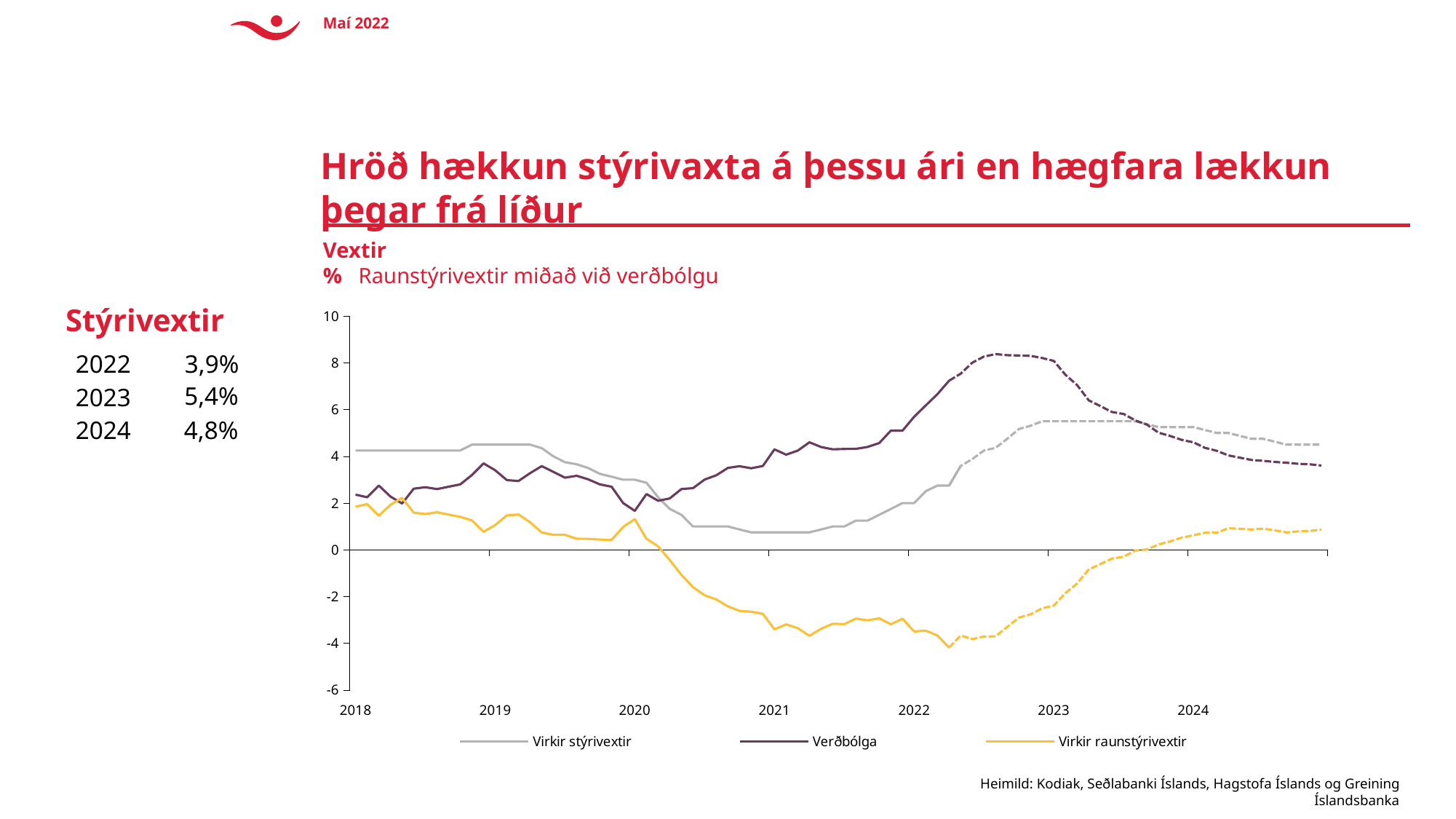
Is the value of Verðbólga at the 2022 tick greater or less than 4? greater Does Verðbólga rise or fall between the 2021 and 2022 ticks? rise What is the title of the chart? Vextir Is the value of Virkir stýrivextir at the 2019 tick greater or less than 4? greater At the 2022 tick, which is higher: Verðbólga or Virkir stýrivextir? Verðbólga Which series reaches the lowest value anywhere on the chart? Virkir raunstýrivextir How many series does the legend list? 3 What kind of chart is shown on the slide? line chart Is the value of Virkir raunstýrivextir at the 2021 tick greater or less than -2? less What are the three series named in the legend? Virkir stýrivextir, Verðbólga, Virkir raunstýrivextir Which series reaches the highest value anywhere on the chart? Verðbólga At the 2018 tick, which is higher: Virkir stýrivextir or Verðbólga? Virkir stýrivextir